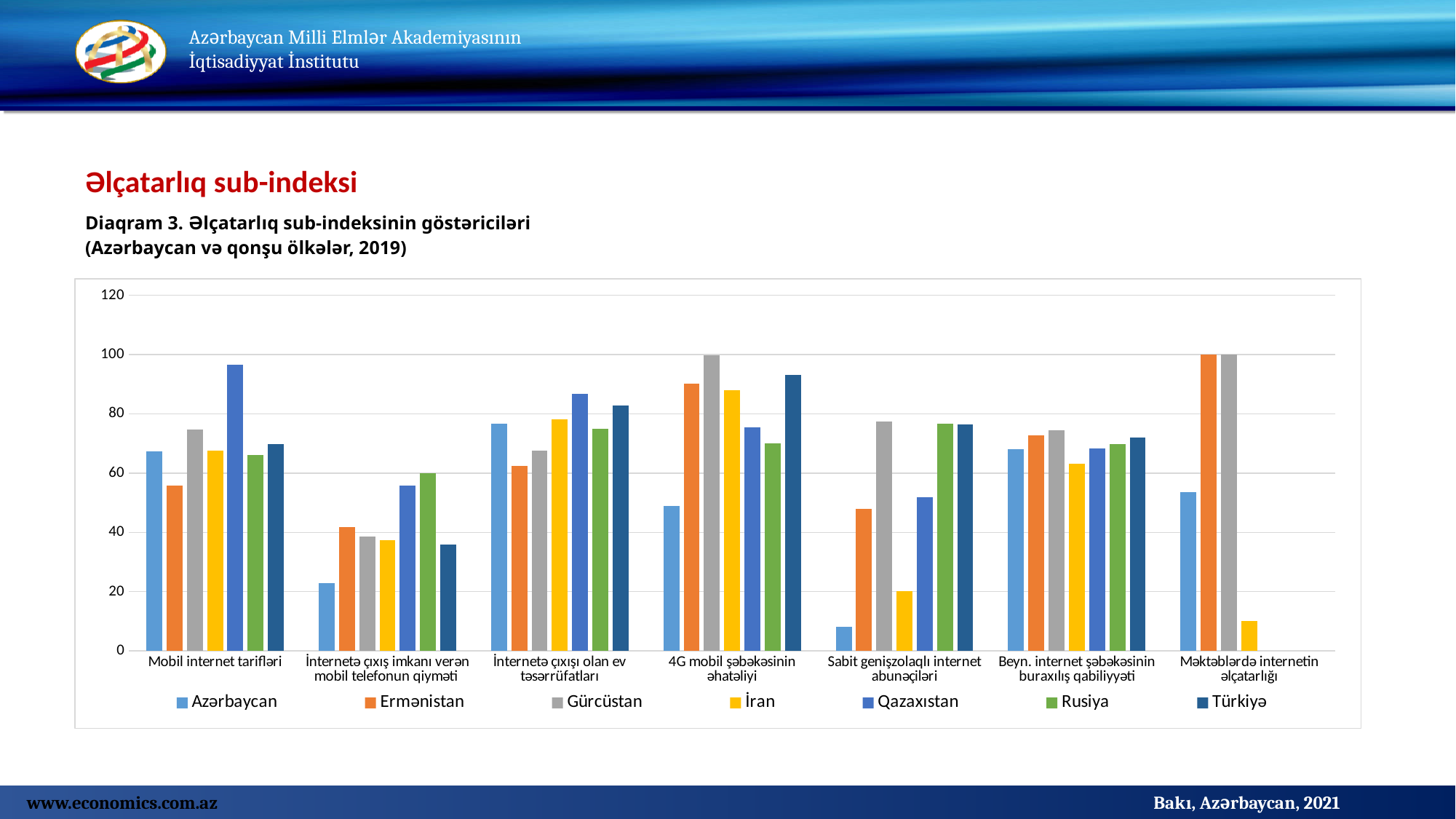
What is the title of the diagram shown on the slide? Diaqram 3. Əlçatarlıq sub-indeksinin göstəriciləri (Azərbaycan və qonşu ölkələr, 2019) Is the value for Azərbaycan in 4G mobil şəbəkəsinin əhatəliyi greater or less than 60? less What kind of chart is shown on the slide? bar chart How many categories are shown along the x axis? 7 Is the value for Qazaxıstan in Mobil internet tarifləri greater or less than 80? greater Which country has the lowest value for 4G mobil şəbəkəsinin əhatəliyi? Azərbaycan For Mobil internet tarifləri, which is larger: the value for Azərbaycan or the value for Ermənistan? Azərbaycan Is the value for İran in Məktəblərdə internetin əlçatarlığı greater or less than 20? less How many series does the legend list? 7 Which country has the highest value for İnternetə çıxış imkanı verən mobil telefonun qiyməti? Rusiya Which country has the lowest value for Sabit genişzolaqlı internet abunəçiləri? Azərbaycan Which country has the highest value for Mobil internet tarifləri? Qazaxıstan